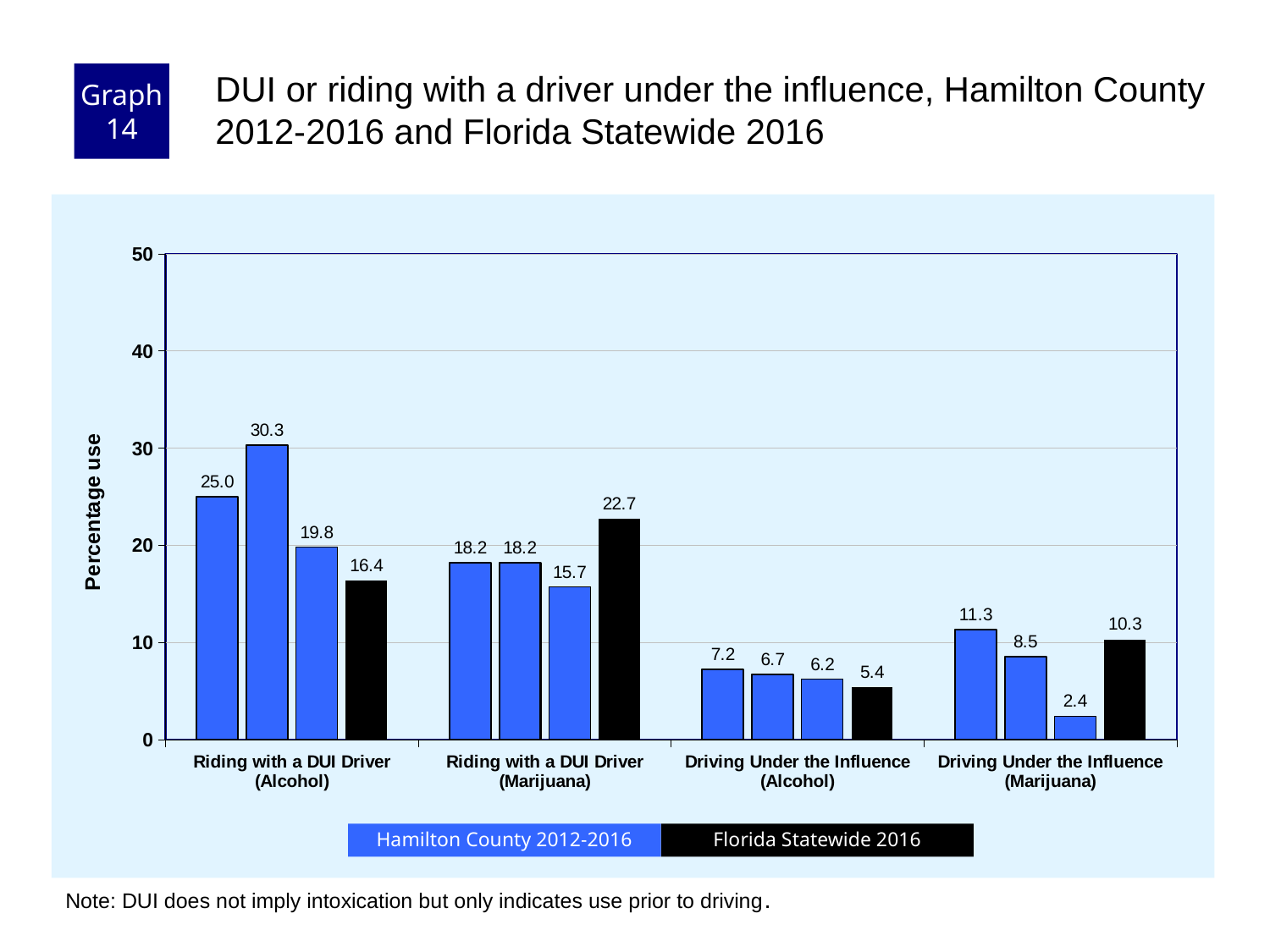
What is the Florida Statewide 2016 value for Riding with a DUI Driver (Alcohol)? 16.4 How many series does the legend list? 2 For Florida Statewide 2016, which is larger: Riding with a DUI Driver (Marijuana) or Riding with a DUI Driver (Alcohol)? Riding with a DUI Driver (Marijuana) What is the difference between the Florida Statewide 2016 values for Driving Under the Influence (Marijuana) and Driving Under the Influence (Alcohol)? 4.9 What is the value of the first Hamilton County 2012-2016 bar in the Riding with a DUI Driver (Alcohol) group? 25.0 How many categories are shown on the x axis? 4 What is the difference between the Florida Statewide 2016 values for Riding with a DUI Driver (Marijuana) and Riding with a DUI Driver (Alcohol)? 6.3 What kind of chart is shown on the slide? bar chart What is the Florida Statewide 2016 value for Driving Under the Influence (Marijuana)? 10.3 Which category contains the tallest bar on the chart? Riding with a DUI Driver (Alcohol) What is the lowest value shown on the chart? 2.4 Is the Florida Statewide 2016 value for Driving Under the Influence (Alcohol) greater or less than 10? less